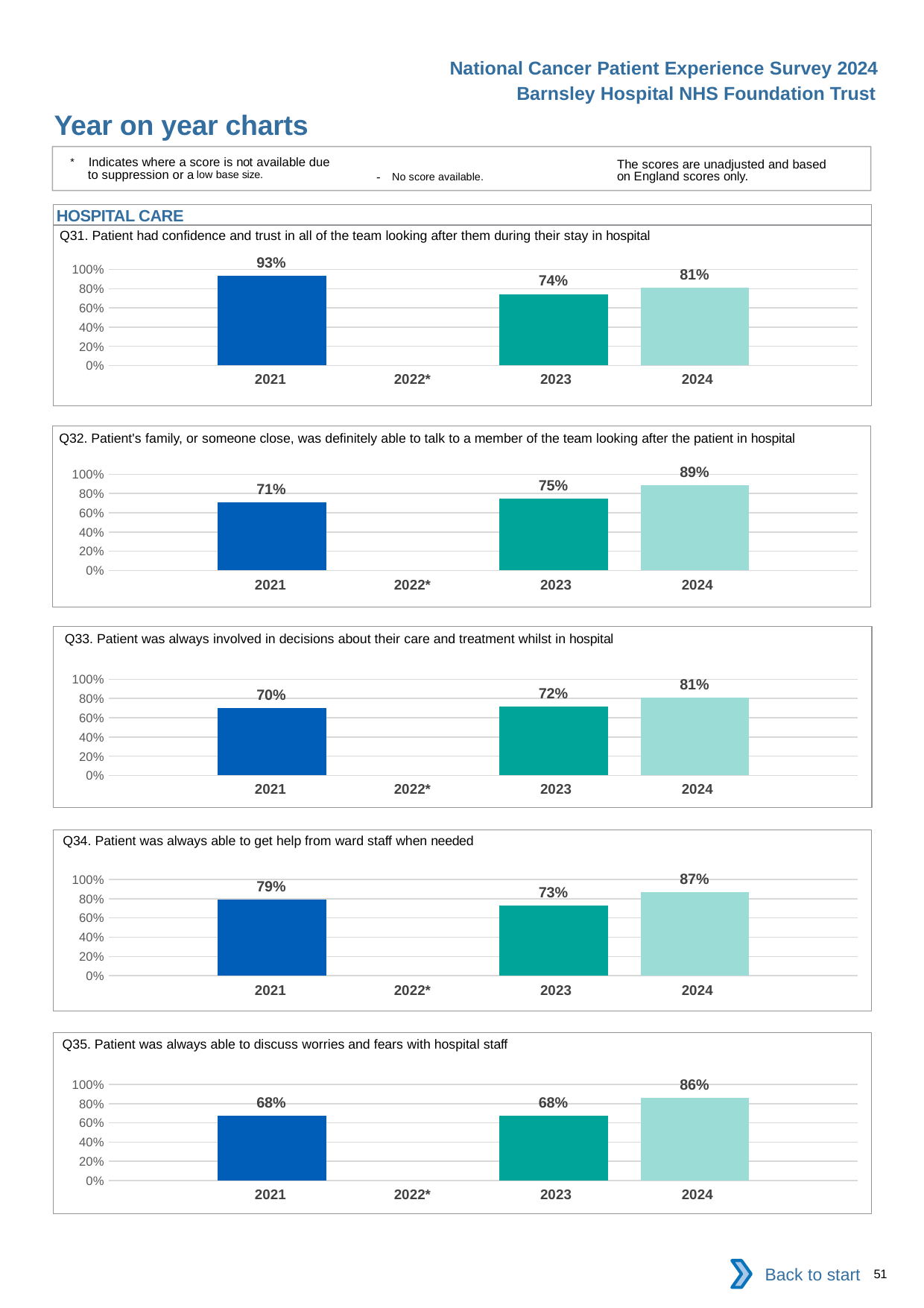
What type of chart is used for Q33? Bar chart Which year is marked with an asterisk in the Q31 chart, indicating no score available? 2022* In the Q34 chart, which is larger, the value for 2021 or the value for 2023? 2021 In the Q31 chart, what is the value for 2021? 93% In the Q31 chart, which year has the lowest value among those with a score shown? 2023 In the Q34 chart, what is the difference between the 2024 and 2023 values? 14 percentage points In the Q32 chart, which year has the highest value? 2024 In the Q35 chart, what is the value for 2024? 86% In the Q33 chart, what is the difference between the 2024 and 2021 values? 11 percentage points How many year categories are shown on the x axis of the Q32 chart? 4 In the Q35 chart, is the value for 2021 greater or less than 80%? less In the Q32 chart, what is the value for 2023? 75%